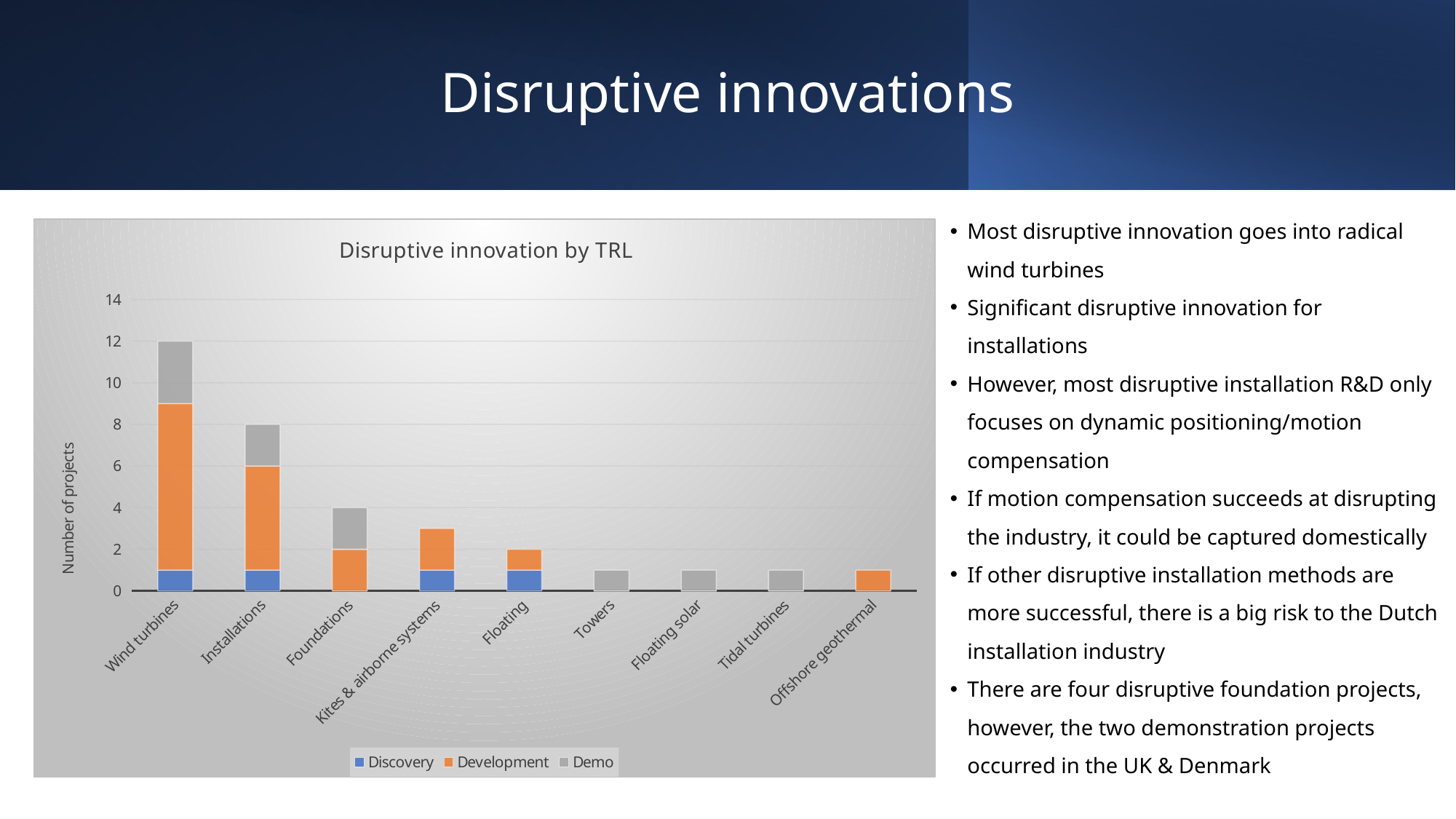
Which series are listed in the chart legend? Discovery, Development, Demo How many categories are shown on the x axis of the chart? 9 What kind of chart is shown on the slide? Stacked bar chart Is the total value for Kites & airborne systems greater or less than 2? greater What is the total number of projects for Wind turbines? 12 Which category has the highest total number of projects? Wind turbines What is the total number of projects for Foundations? 4 What is the total number of projects for Installations? 8 Do the total values generally rise or fall moving from left to right along the x axis? Fall How many series does the chart legend list? 3 What is the title of the chart? Disruptive innovation by TRL What is the difference between the total for Wind turbines and the total for Installations? 4